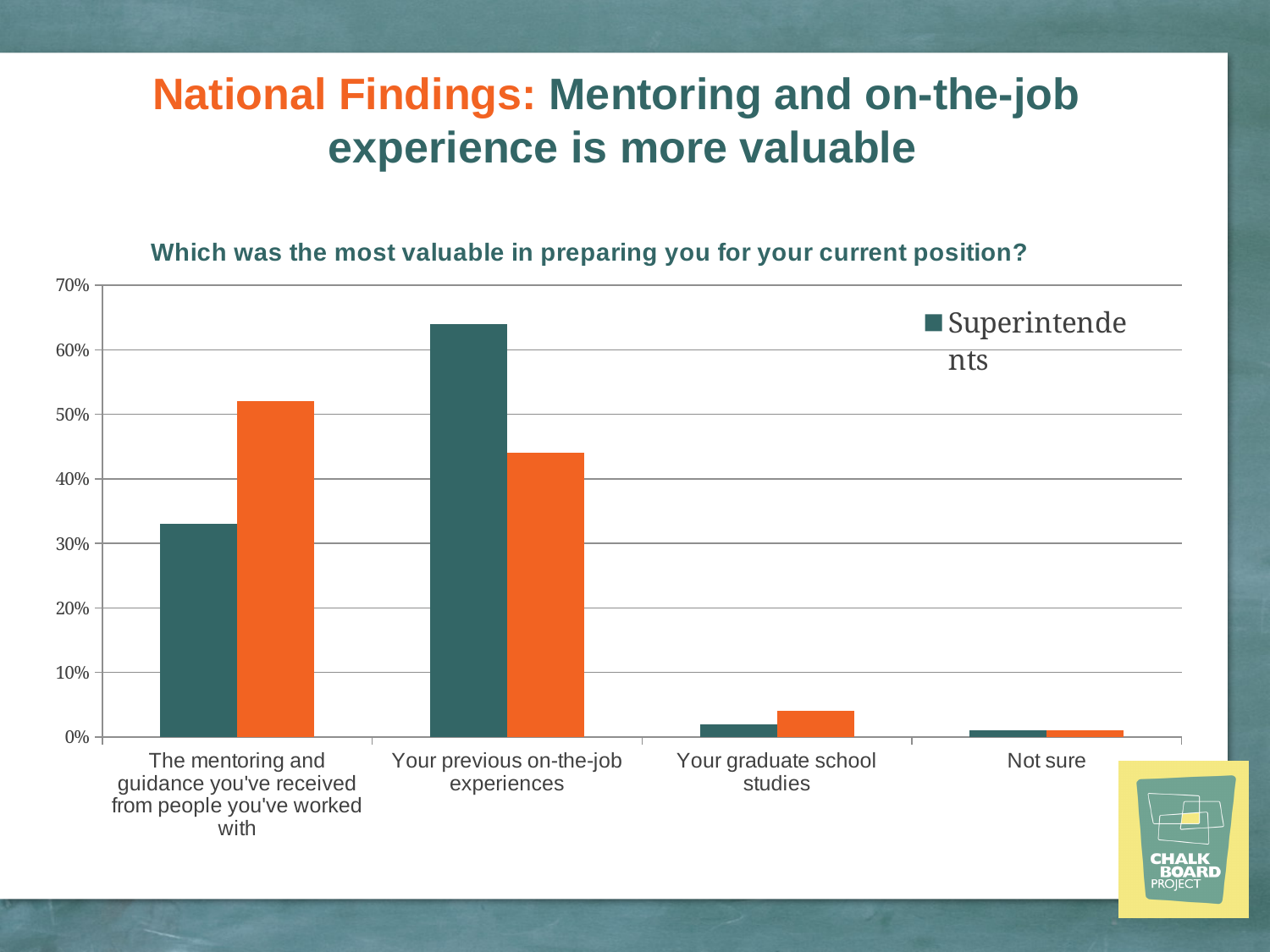
Is the Superintendents value for 'The mentoring and guidance you've received from people you've worked with' greater or less than 40%? less Is the Superintendents value for 'Your previous on-the-job experiences' greater or less than 60%? greater Is the orange bar for 'Your previous on-the-job experiences' greater or less than 50%? less For Superintendents, which is larger: 'The mentoring and guidance you've received from people you've worked with' or 'Your previous on-the-job experiences'? Your previous on-the-job experiences Which category has the highest Superintendents (teal) bar? Your previous on-the-job experiences Which series name is readable in the chart legend? Superintendents Which category has the lowest Superintendents (teal) bar? Not sure How many categories are shown along the x axis of the chart? 4 What kind of chart is shown on the slide? Bar chart What is the title of the chart? Which was the most valuable in preparing you for your current position?